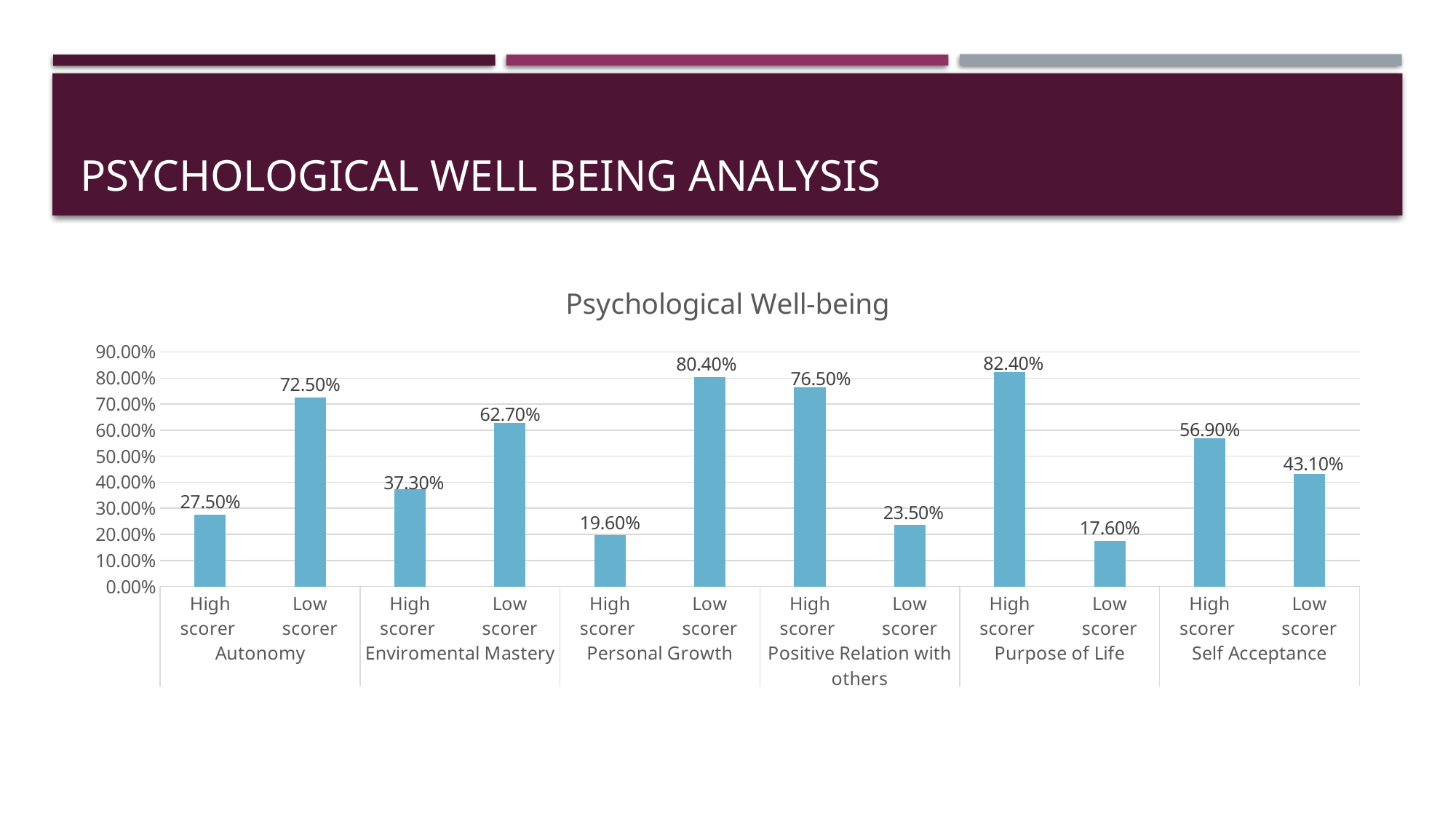
What is the value for Low scorer under Self Acceptance? 43.10% What is the value for Low scorer under Autonomy? 72.50% How many bars are plotted in the chart? 12 Which bar has the lowest value in the chart? Low scorer, Purpose of Life (17.60%) What kind of chart is shown on the slide? Bar chart What is the difference between the Low scorer and High scorer values under Autonomy? 45.00% What is the title of the chart? Psychological Well-being Which bar has the highest value in the chart? High scorer, Purpose of Life (82.40%) Which is larger: the High scorer value under Environmental Mastery or the High scorer value under Self Acceptance? High scorer under Self Acceptance What is the value for High scorer under Personal Growth? 19.60% What is the difference between the High scorer and Low scorer values under Self Acceptance? 13.80% What is the value for High scorer under Purpose of Life? 82.40%